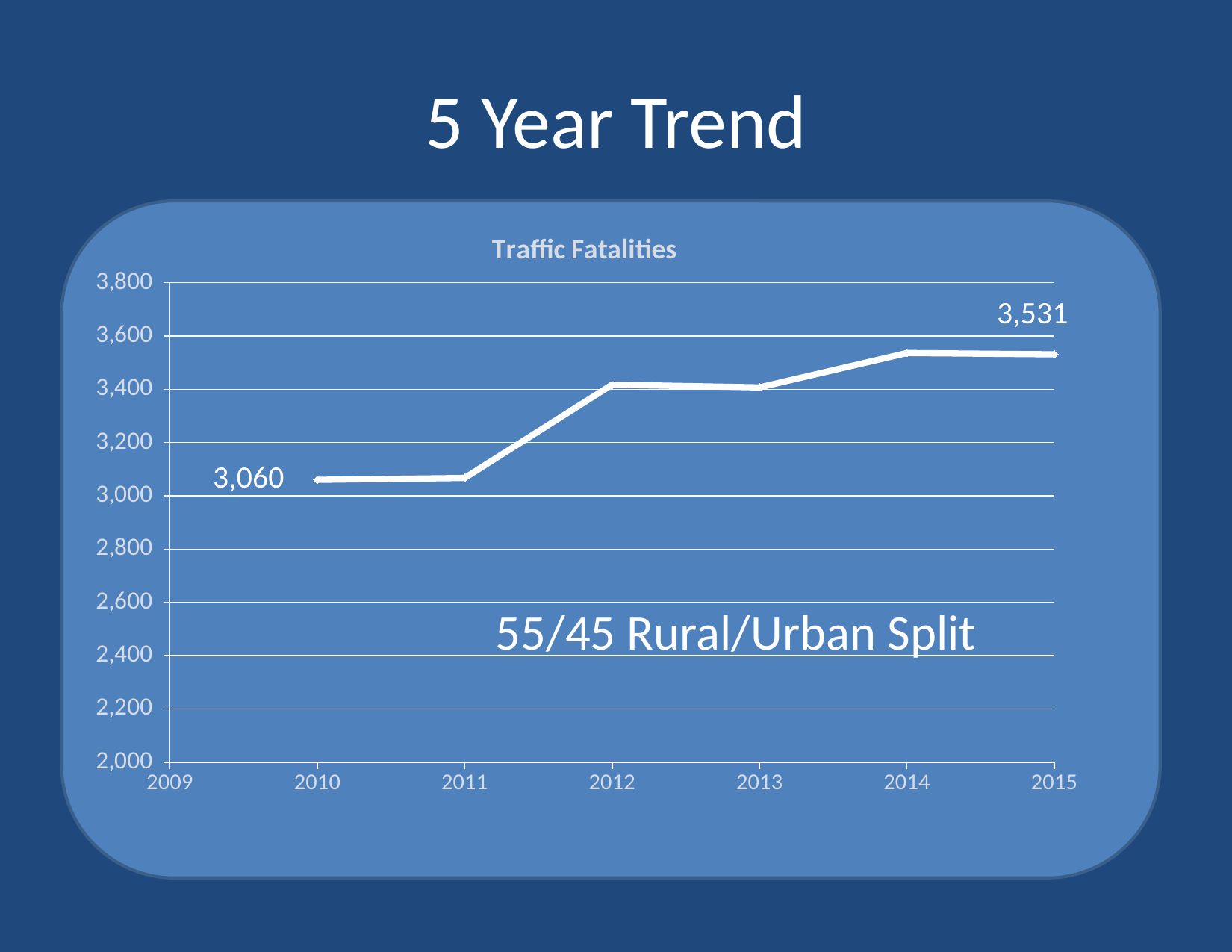
Do traffic fatalities generally rise or fall from 2010 to 2015? Rise What is the value for 2015 on the Traffic Fatalities chart? 3,531 Is the value for 2013 greater or less than 3,600? less Is the value for 2012 greater or less than 3,200? greater Is the value for 2011 greater or less than 3,200? less Which year has the larger value, 2012 or 2014? 2014 What is the value for 2010 on the Traffic Fatalities chart? 3,060 What text annotation is written inside the chart area? 55/45 Rural/Urban Split What kind of chart is shown on the slide? Line chart How many years have a plotted data point on the Traffic Fatalities chart? 6 By how much did traffic fatalities increase from 2010 to 2015? 471 Which year has the larger value, 2010 or 2012? 2012